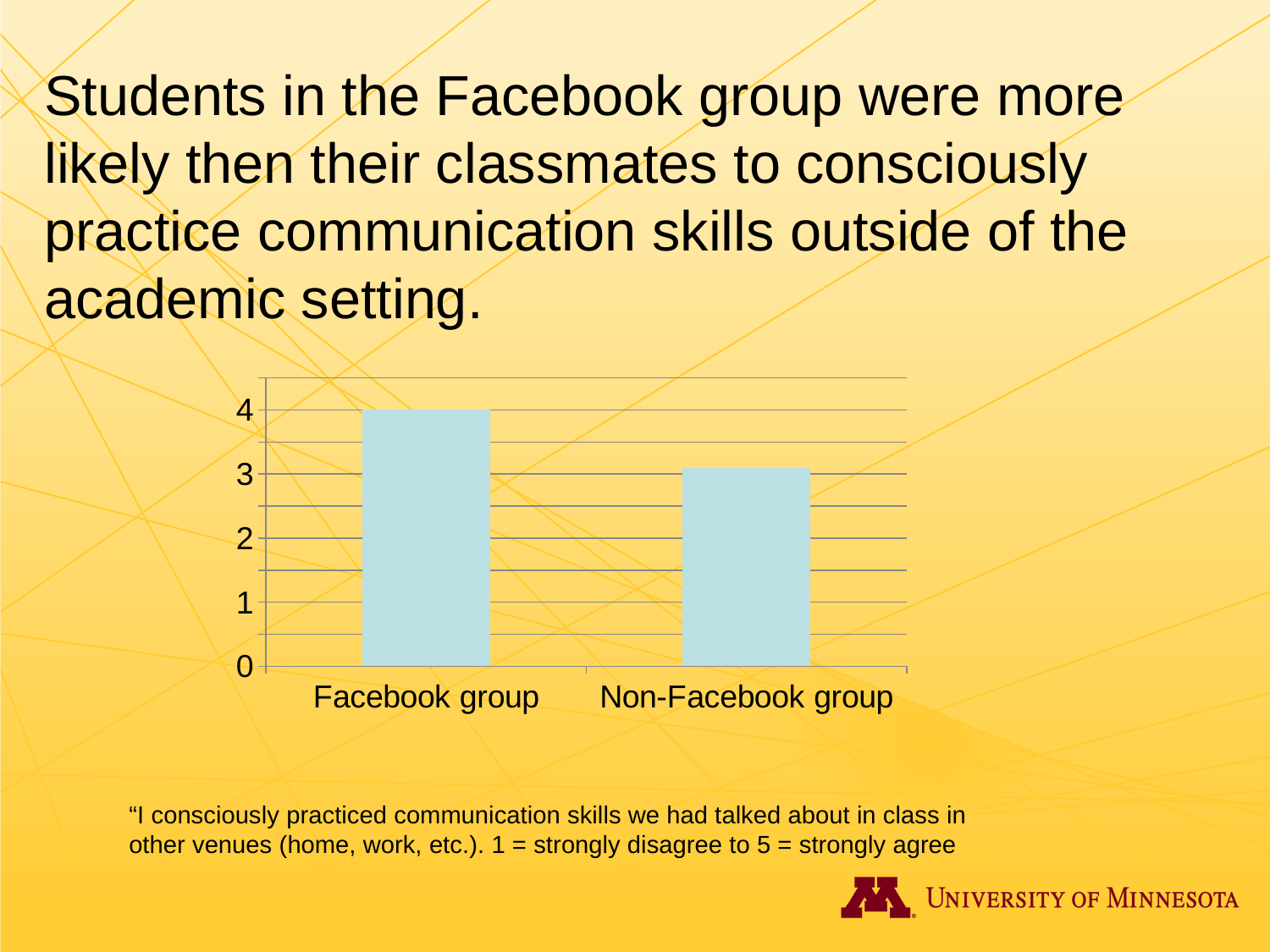
Is the value for the Facebook group greater or less than 3? greater Which group has the lower bar in the chart? Non-Facebook group What is the highest value labelled on the y axis of the chart? 4 What is the value for the Facebook group? 4 What is the label of the second category on the x axis? Non-Facebook group What kind of chart is shown on the slide? bar chart Which group has the higher bar in the chart? Facebook group Is the value for the Non-Facebook group greater or less than 2? greater How many categories are shown on the x axis of the chart? 2 Is the value for the Non-Facebook group greater or less than 4? less Which is larger, the value for the Facebook group or the value for the Non-Facebook group? Facebook group